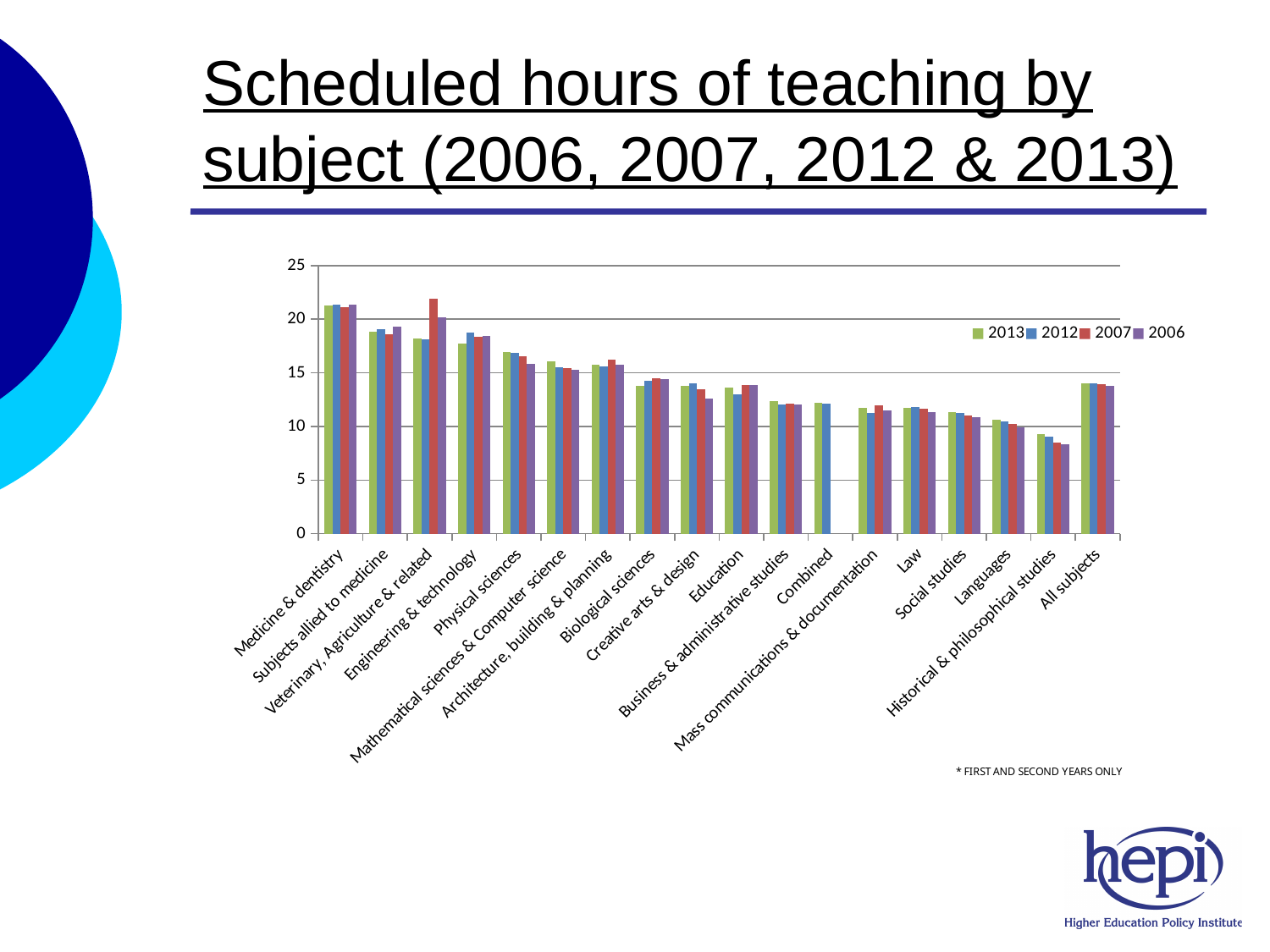
Which is larger, the 2013 value for Physical sciences or the 2013 value for Languages? Physical sciences Is the 2013 value for Engineering & technology greater or less than 15? greater Do the 2013 values generally rise or fall moving from Medicine & dentistry to Historical & philosophical studies along the x axis? fall How many subject categories are shown along the x axis? 18 Is the 2013 value for Historical & philosophical studies greater or less than 10? less Which subject has the highest 2013 value? Medicine & dentistry Which subject has the lowest 2013 value? Historical & philosophical studies Is the 2013 value for Medicine & dentistry greater or less than 20? greater Which years are listed in the chart legend? 2013, 2012, 2007, 2006 How many series does the legend list? 4 What kind of chart is shown on the slide? bar chart